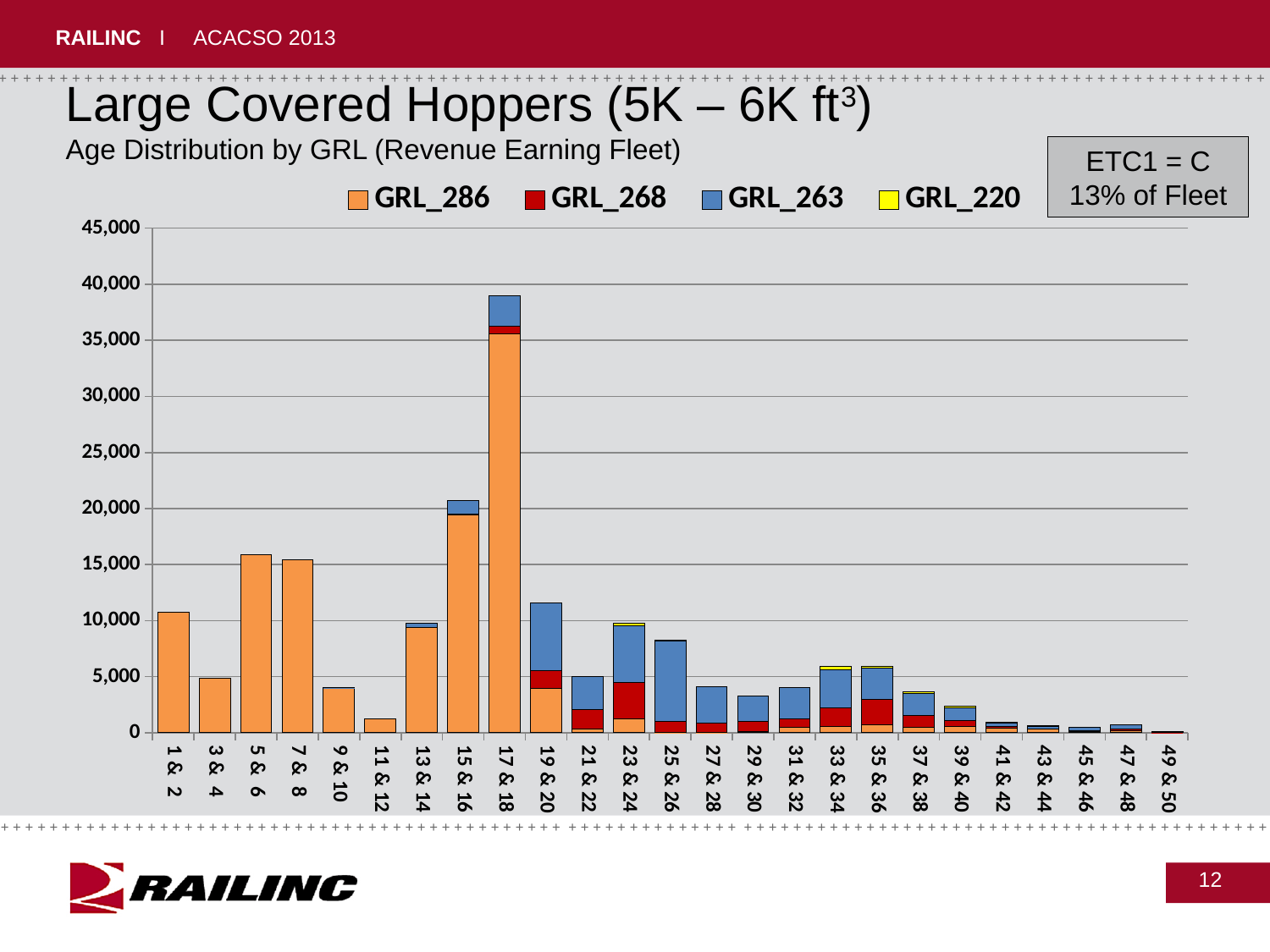
What kind of chart is shown on the slide? Stacked bar chart Is the total bar for 11 & 12 greater or less than 5,000? less Is the total bar for 25 & 26 greater or less than 10,000? less Which age group has the tallest bar? 17 & 18 Which bar is taller, 19 & 20 or 21 & 22? 19 & 20 How many age-group categories are shown on the x axis? 25 Which age group has the shortest bar? 49 & 50 Is the total bar for 1 & 2 greater or less than 10,000? greater Which series is shown in orange in the legend? GRL_286 Which bar is taller, 1 & 2 or 3 & 4? 1 & 2 How many series does the legend list? 4